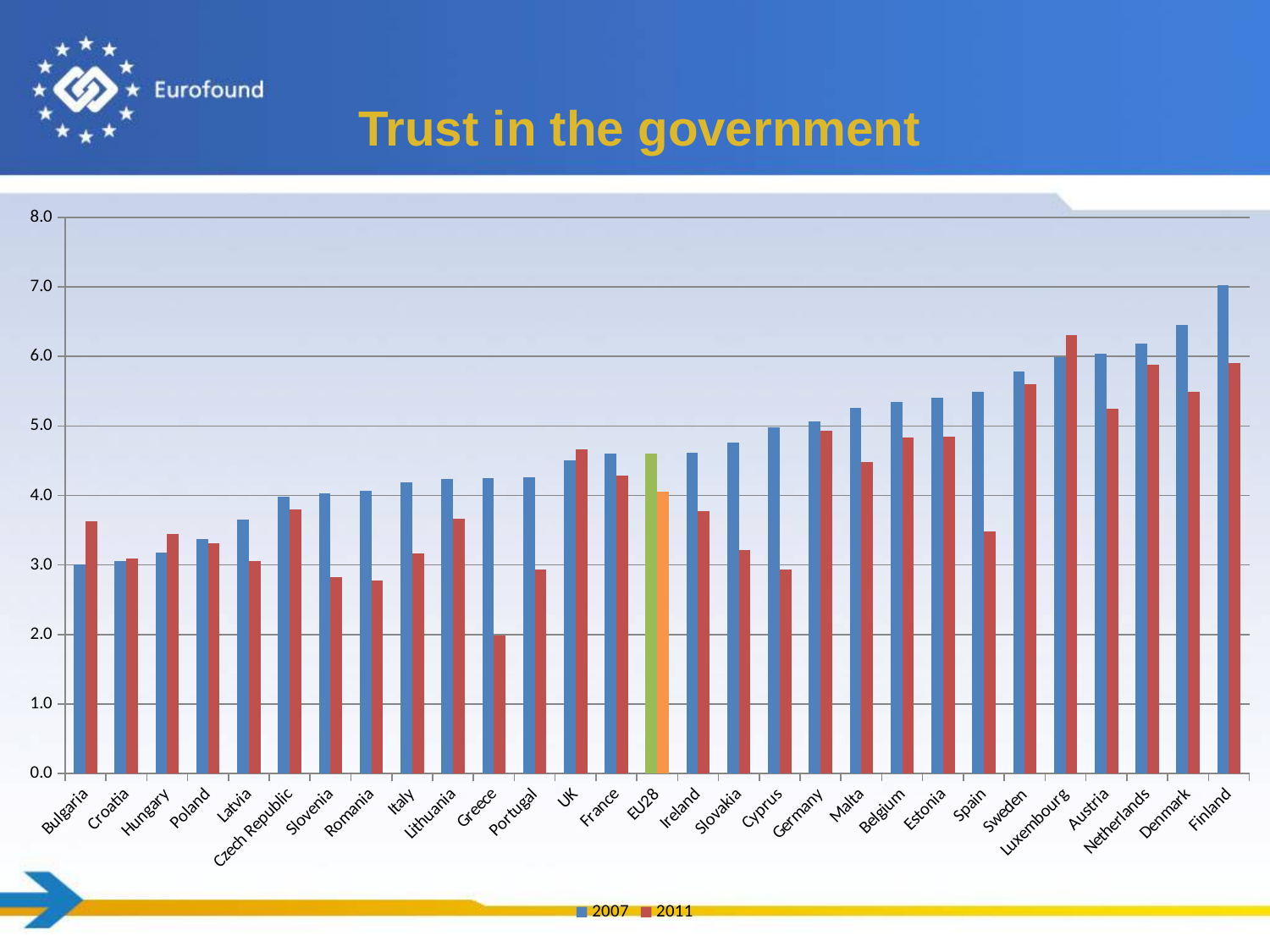
How many series does the legend list? 2 Which category has the highest value for 2007? Finland How many countries/categories are shown on the x axis? 29 Which category has the lowest value for 2011? Greece What kind of chart is shown on the slide? bar chart Is the 2011 value for Greece greater or less than 3.0? less For Greece, which is larger: the 2007 value or the 2011 value? 2007 Do the 2007 values generally rise or fall moving from left to right along the x axis? rise For Bulgaria, which is larger: the 2007 value or the 2011 value? 2011 Which category has the highest value for 2011? Luxembourg Is the 2011 value for Spain greater or less than 4.0? less Is the 2007 value for Finland greater or less than 6.0? greater